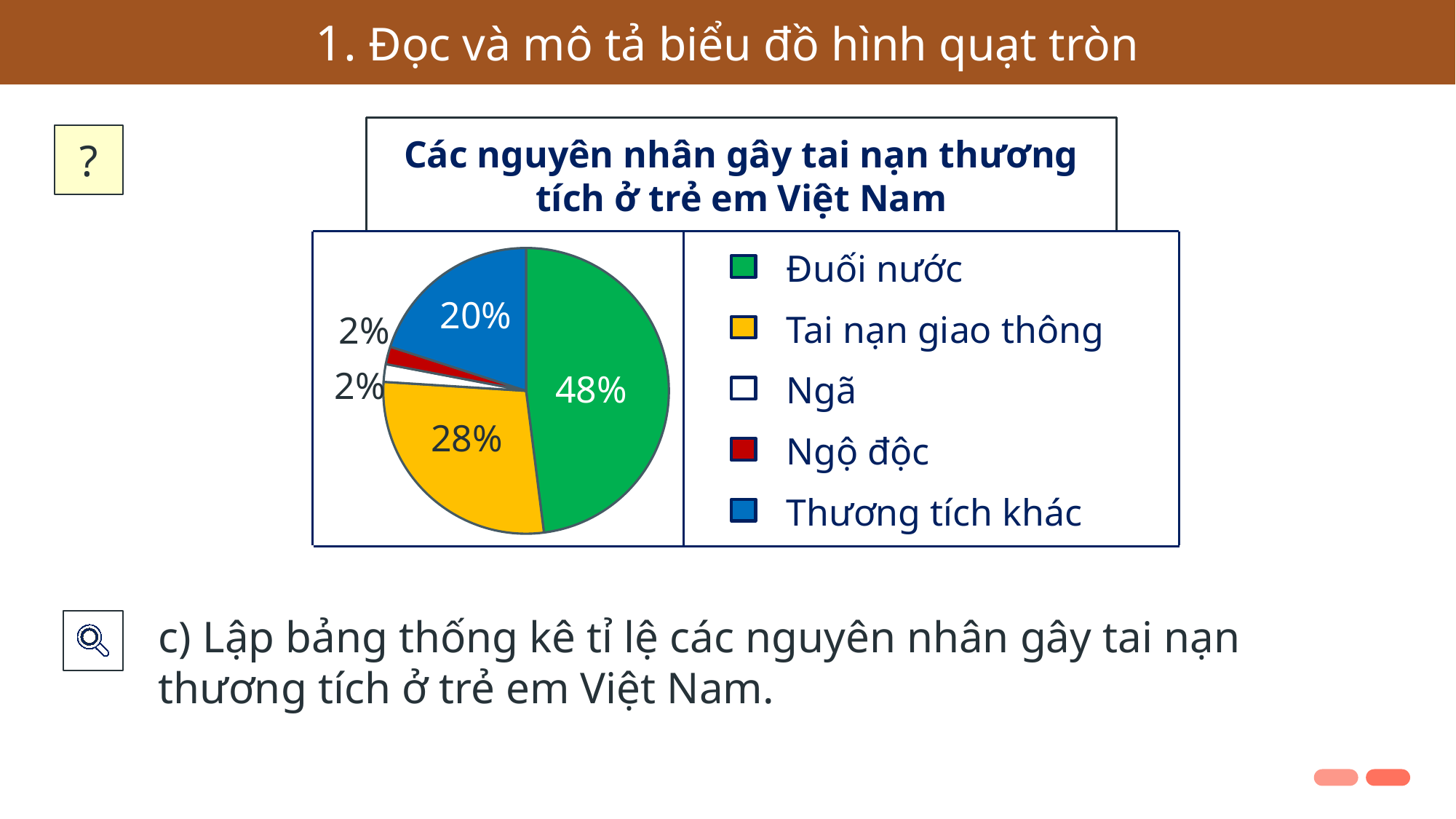
What percentage of the pie is Tai nạn giao thông? 28% How many categories does the legend list? 5 Which has a larger share, Tai nạn giao thông or Thương tích khác? Tai nạn giao thông What colour is the slice for Thương tích khác? Blue What is the title of the pie chart? Các nguyên nhân gây tai nạn thương tích ở trẻ em Việt Nam What percentage of the pie is Thương tích khác? 20% Which cause has the largest share of the pie? Đuối nước What percentage of the pie is Ngộ độc? 2% What kind of chart is shown on the slide? Pie chart What percentage of the pie is Đuối nước? 48% What percentage of the pie is Ngã? 2% What is the difference between the shares of Đuối nước and Tai nạn giao thông? 20%